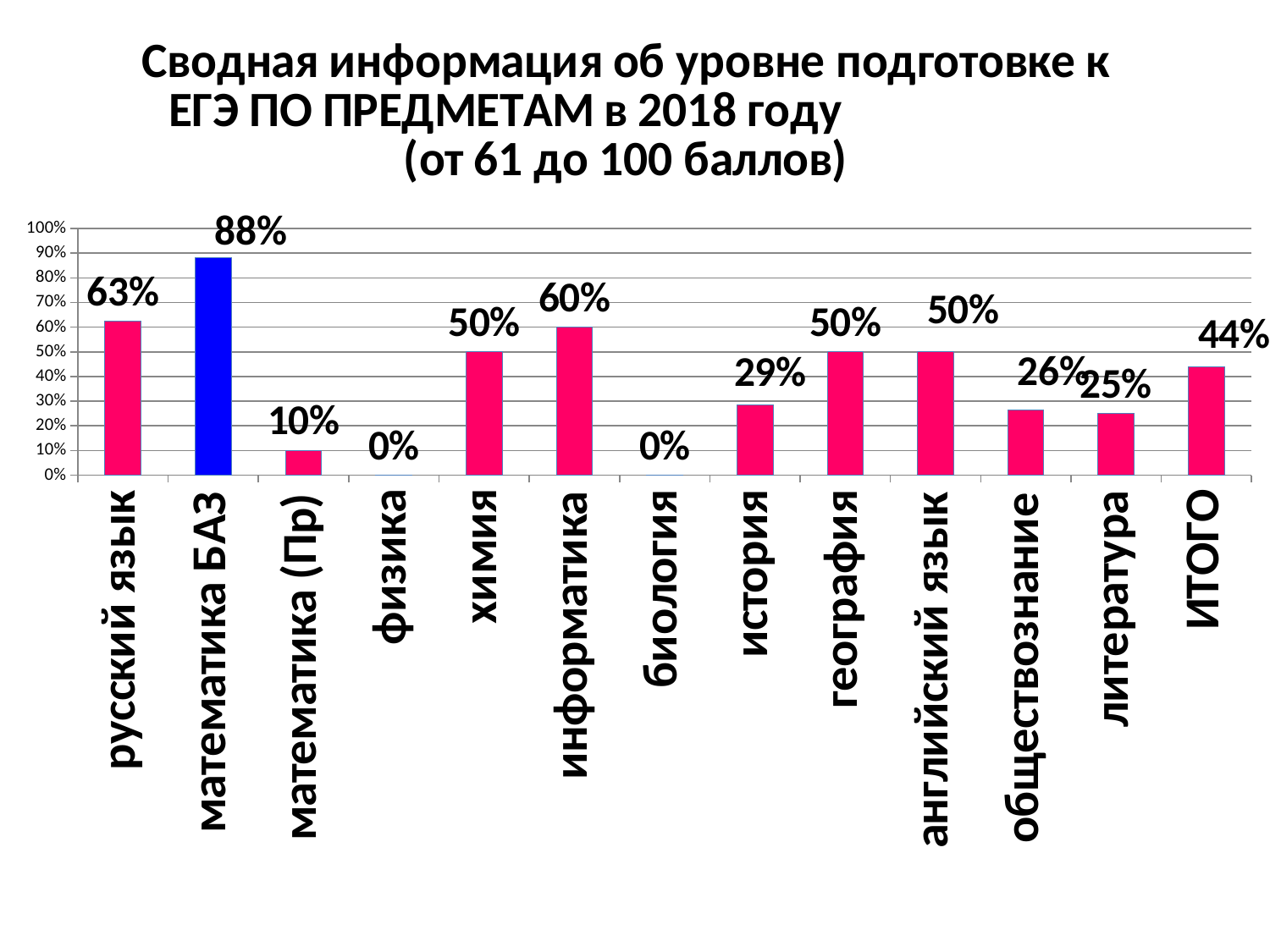
What is the value for информатика? 60% Which bar is coloured differently (blue) from the others? математика БАЗ Which is larger, the value for история or the value for литература? история What is the value for ИТОГО? 44% What is the difference between the values for русский язык and ИТОГО? 19% How many categories are shown on the x axis? 13 What is the difference between the values for математика БАЗ and математика (Пр)? 78% What is the value for русский язык? 63% What is the value for обществознание? 26% Which category has the highest value? математика БАЗ Which categories have a value of 0%? физика and биология What kind of chart is this? bar chart